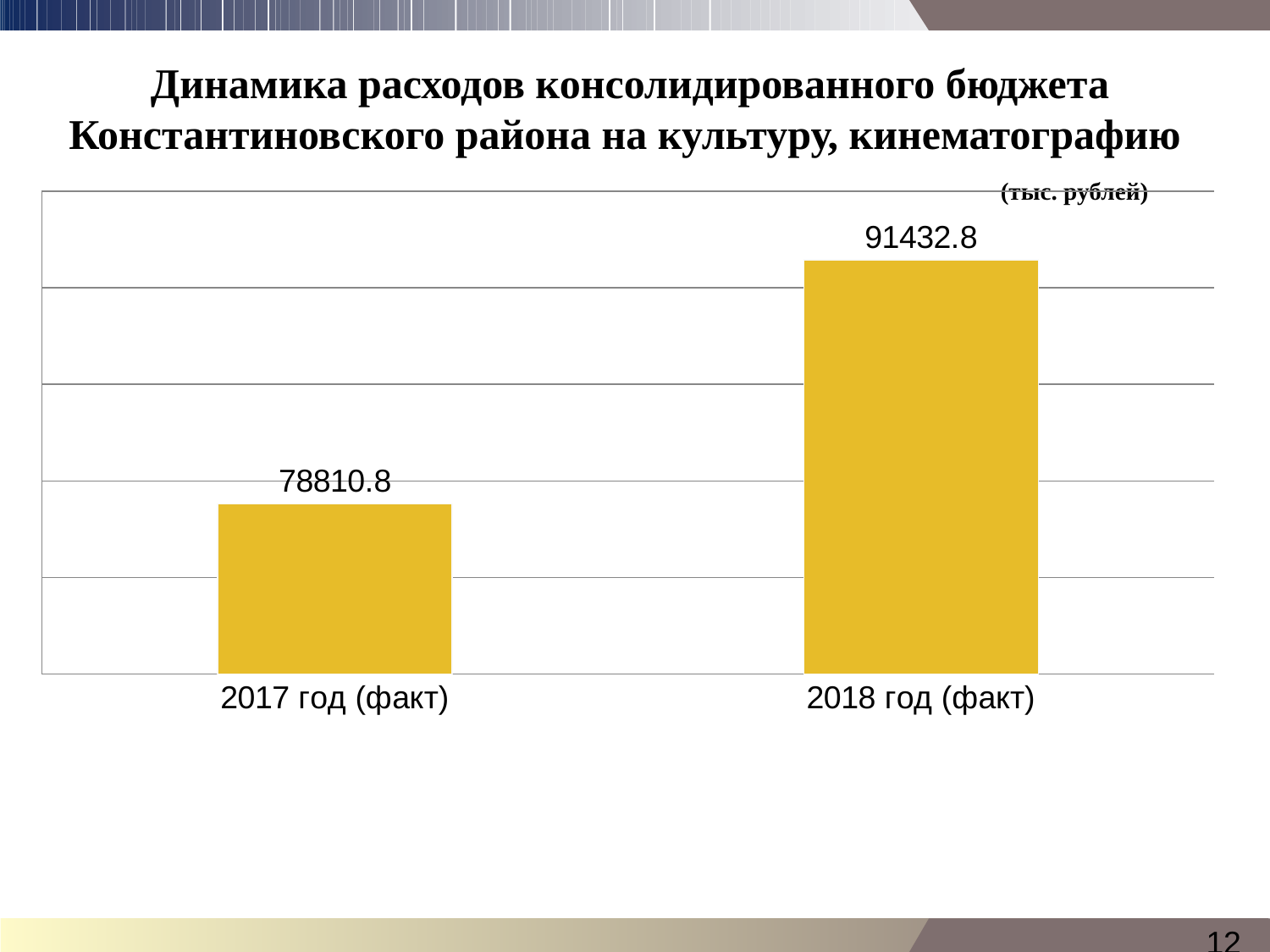
What colour are the bars in the chart? Yellow What is the value for 2018 год (факт)? 91432.8 Which is larger, the value for 2017 год (факт) or 2018 год (факт)? 2018 год (факт) What unit is indicated for the values in the chart? тыс. рублей Do the values rise or fall from 2017 год (факт) to 2018 год (факт)? Rise What kind of chart is shown on the slide? Bar chart How many categories are shown in the chart? 2 Which category has the lowest value? 2017 год (факт) What is the difference between the values for 2018 год (факт) and 2017 год (факт)? 12622 What is the value for 2017 год (факт)? 78810.8 Which category has the highest value? 2018 год (факт)